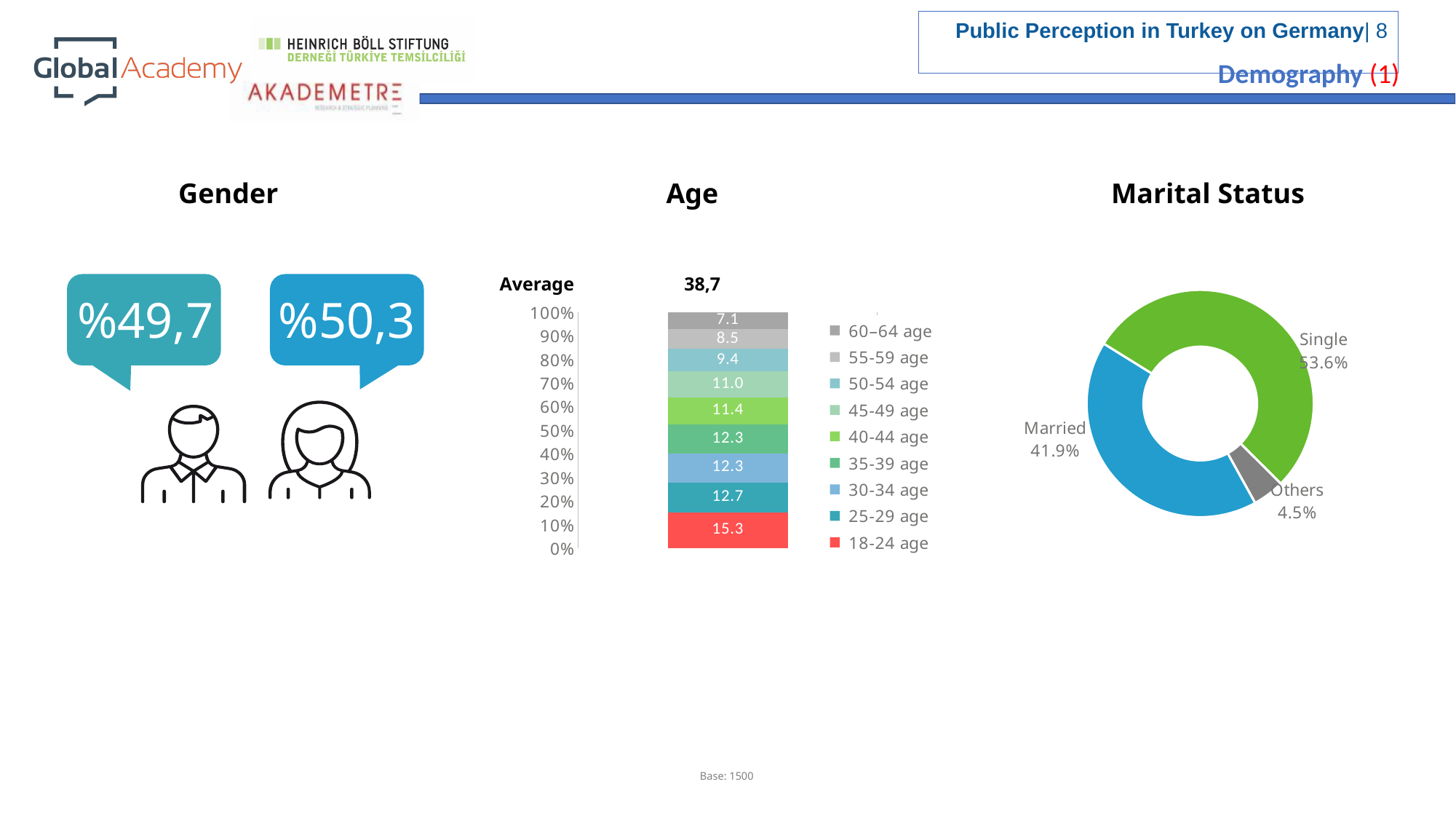
In the Age chart, which age group has the smallest value? 60–64 age What average value is shown above the Age chart? 38,7 In the Marital Status chart, what share is Single? 53.6% In the Age chart, what is the value for the 18-24 age group? 15.3 In the Age chart, which age group has the largest value? 18-24 age In the Marital Status chart, what is the difference between the Single and Married shares? 11.7% How many age groups does the legend of the Age chart list? 9 In the Age chart, which is larger: the 40-44 age group or the 45-49 age group? 40-44 age In the Marital Status chart, which category has the smallest share? Others What kind of chart is the Age chart? Stacked bar chart In the Age chart, what is the value for the 60–64 age group? 7.1 In the Age chart, what is the difference between the 18-24 age group and the 25-29 age group? 2.6